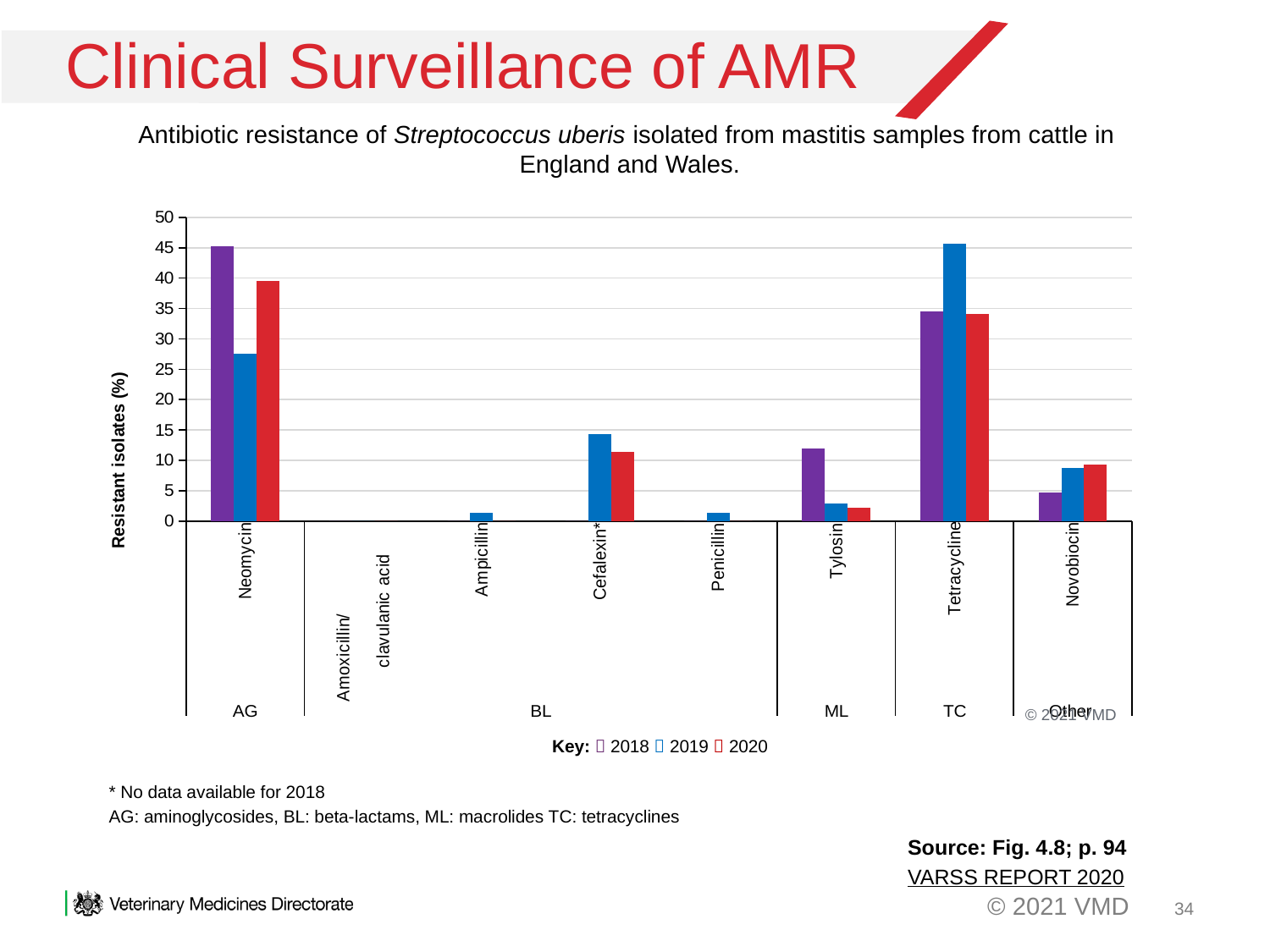
How many series does the key list? 3 Is the value for Neomycin in 2018 greater or less than 40? greater Is the value for Cefalexin* in 2019 greater or less than 10? greater Is the value for Tetracycline in 2019 greater or less than 40? greater How many antibiotics are shown along the x axis? 8 Which antibiotic has the highest percentage of resistant isolates in 2019? Tetracycline For Neomycin, which year has the larger percentage of resistant isolates, 2018 or 2019? 2018 What kind of chart is shown on the slide? bar chart What is the label on the y axis of the chart? Resistant isolates (%) Which antibiotic has the highest percentage of resistant isolates in 2020? Neomycin Which antibiotic has the highest percentage of resistant isolates in 2018? Neomycin